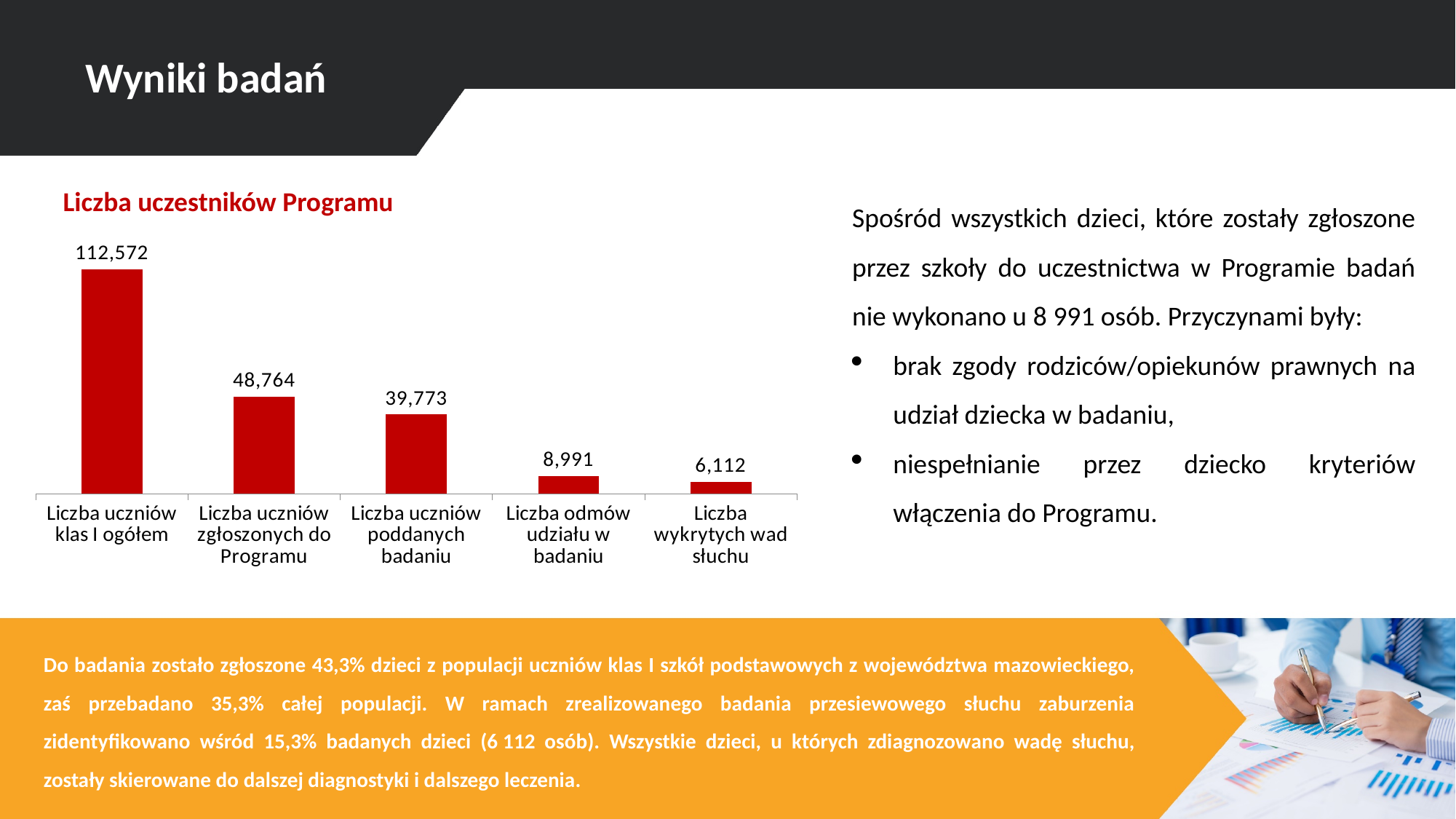
What is the value for "Liczba odmów udziału w badaniu"? 8,991 What is the value for "Liczba wykrytych wad słuchu"? 6,112 What is the title of the chart? Liczba uczestników Programu Which category has the lowest value? Liczba wykrytych wad słuchu How many categories are shown in the chart? 5 What kind of chart is shown on the slide? Bar chart What is the value for "Liczba uczniów klas I ogółem"? 112,572 Which is larger: "Liczba odmów udziału w badaniu" or "Liczba wykrytych wad słuchu"? Liczba odmów udziału w badaniu Which category has the highest value? Liczba uczniów klas I ogółem What is the value for "Liczba uczniów poddanych badaniu"? 39,773 What is the value for "Liczba uczniów zgłoszonych do Programu"? 48,764 What is the difference between "Liczba uczniów zgłoszonych do Programu" and "Liczba uczniów poddanych badaniu"? 8,991